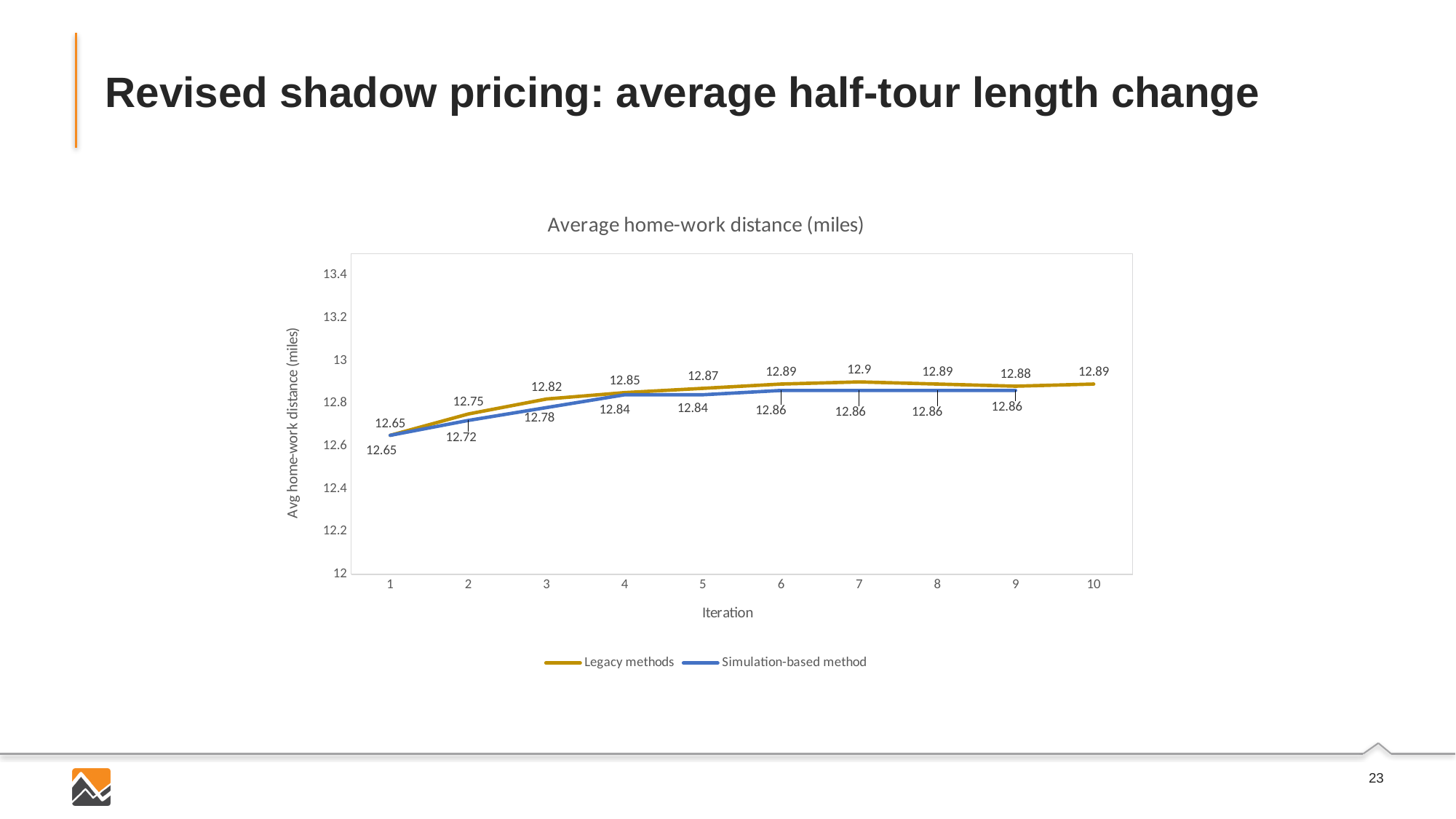
Does the Legacy methods line rise or fall from iteration 1 to iteration 7? rise What is the value for Simulation-based method at iteration 2? 12.72 At which iteration does Legacy methods reach its highest value? 7 What kind of chart is shown on the slide? line chart What is the label of the y axis? Avg home-work distance (miles) How many iterations are shown on the x axis? 10 How many series does the legend list? 2 What is the value for Simulation-based method at iteration 3? 12.78 At iteration 3, which series has the larger value, Legacy methods or Simulation-based method? Legacy methods What is the difference between Legacy methods and Simulation-based method at iteration 2? 0.03 What is the value for Legacy methods at iteration 1? 12.65 What is the value for Legacy methods at iteration 7? 12.9